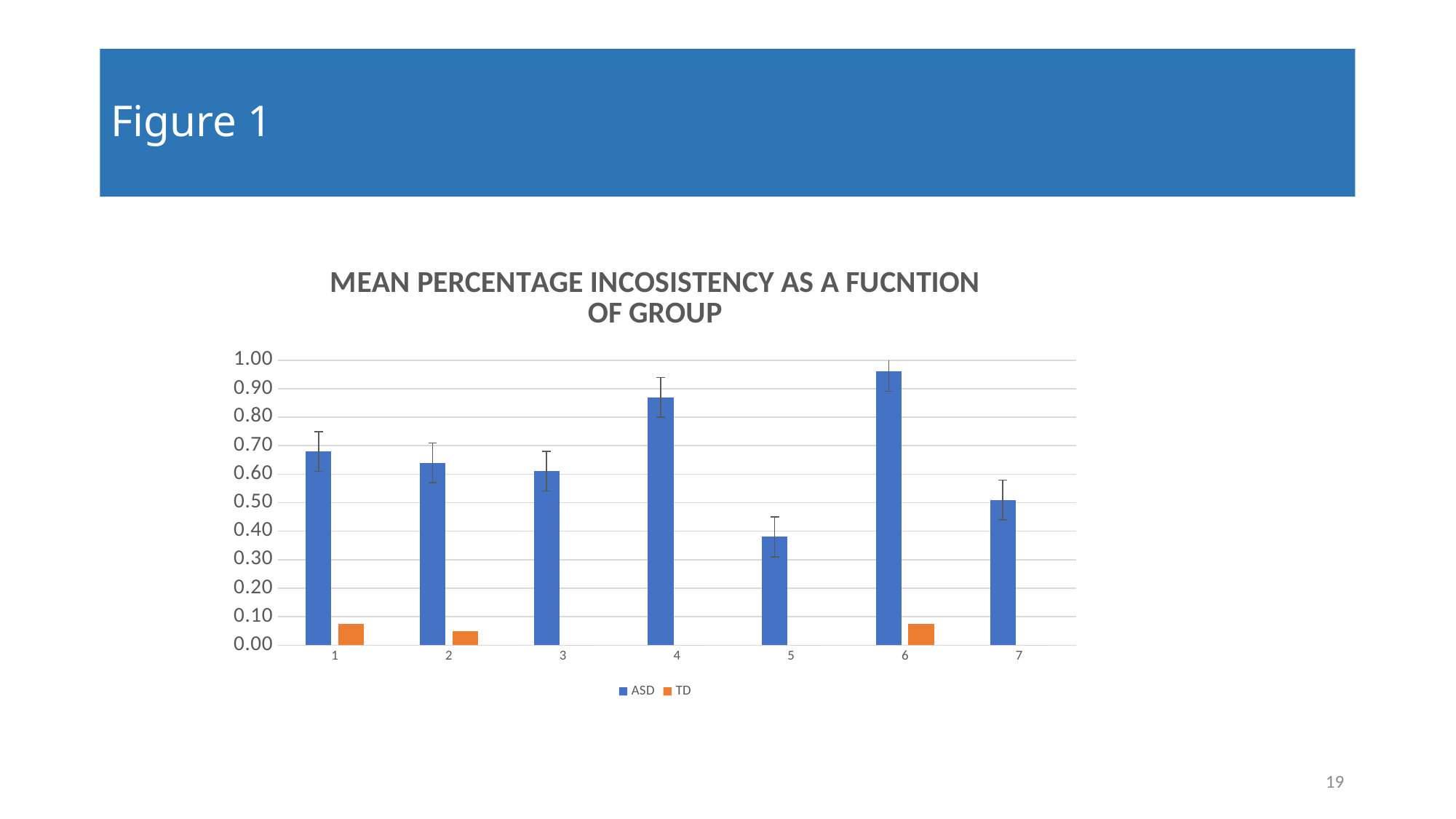
Which series is shown in orange in the legend? TD Which is larger, the ASD value for category 4 or the ASD value for category 1? category 4 Which category has the highest ASD value? 6 Is the ASD value for category 5 greater or less than 0.50? less Is the TD value for category 1 greater or less than 0.10? less Which is larger, the ASD value for category 7 or the ASD value for category 5? category 7 How many categories are shown along the x axis? 7 Which category has the lowest ASD value? 5 What kind of chart is shown on the slide? bar chart Is the ASD value for category 4 greater or less than 0.80? greater How many series does the legend list? 2